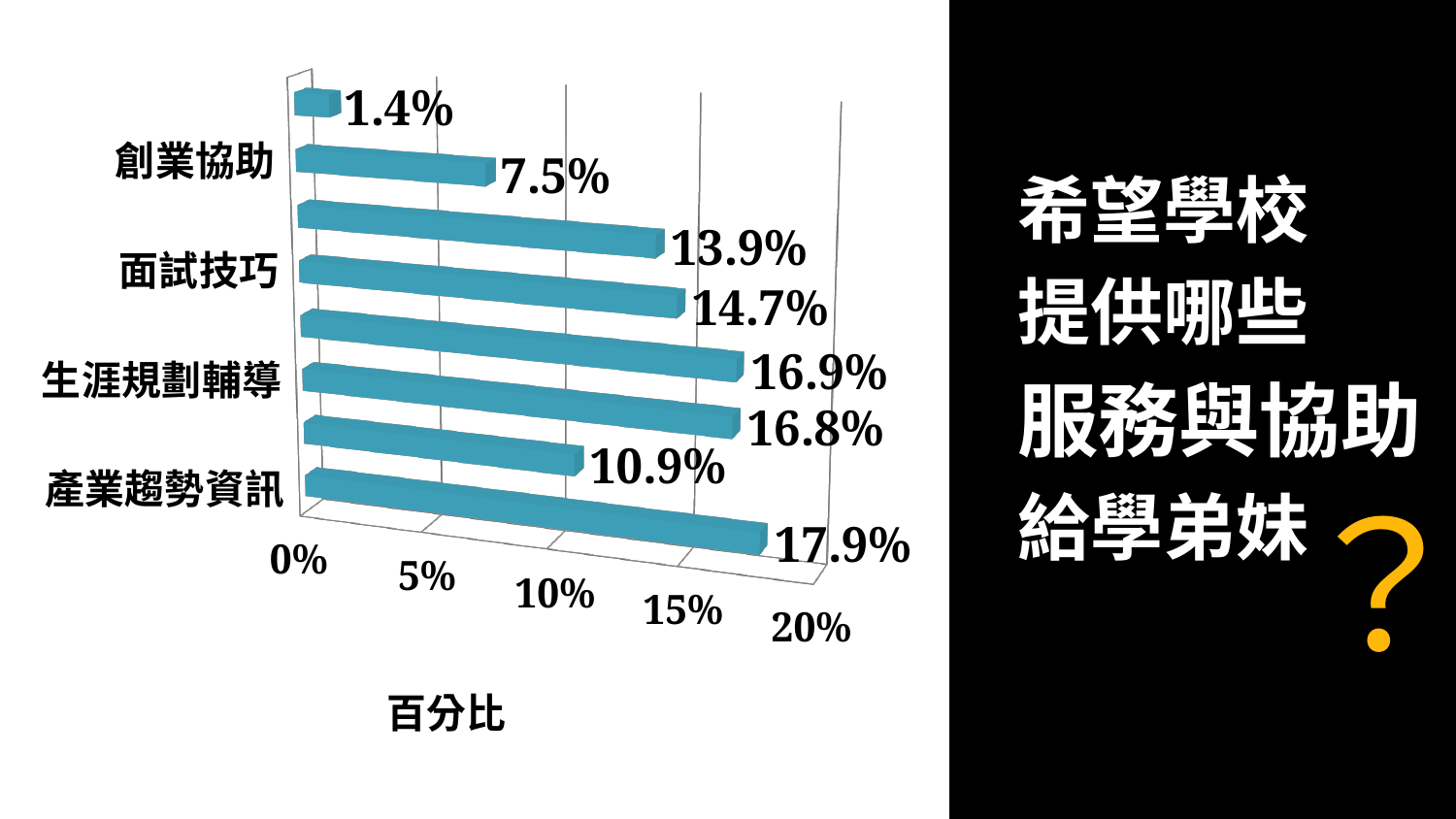
What is the value of the bottom bar in the chart? 17.9% How many bars are plotted in the chart? 8 What is the highest value shown in the chart? 17.9% How many bars have a value greater than 15%? 3 What is the difference between the highest value (17.9%) and the lowest value (1.4%) in the chart? 16.5% What is the title of the horizontal axis of the chart? 百分比 What kind of chart is shown on the slide? bar chart What is the largest tick value shown on the horizontal axis? 20% What is the lowest value shown in the chart? 1.4% What is the second-highest value shown in the chart? 16.9% How many bars have a value below 10%? 2 What is the value of the topmost bar in the chart? 1.4%